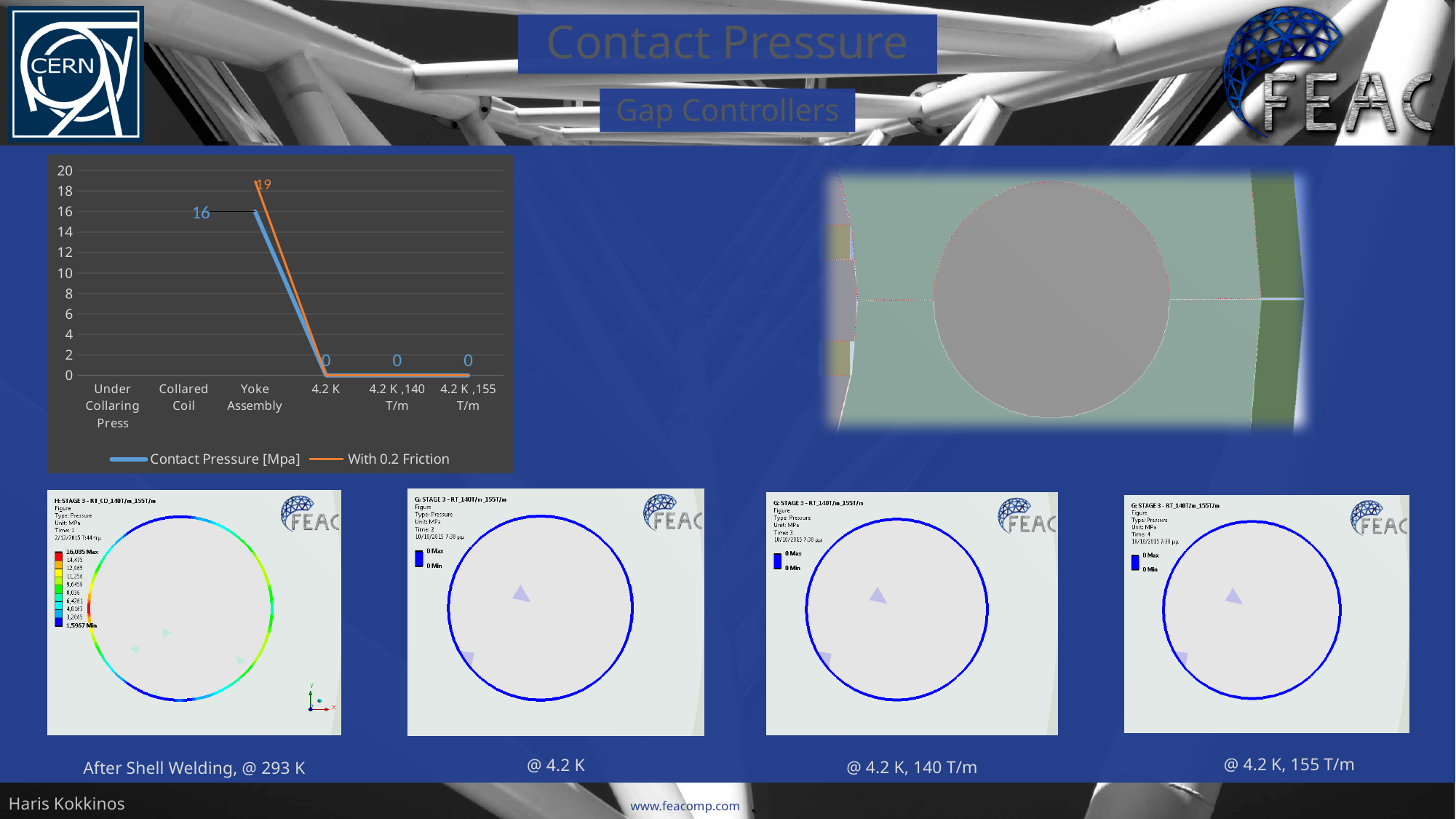
Which category has the highest Contact Pressure [Mpa] value? Yoke Assembly Do the values rise or fall from Yoke Assembly to 4.2 K? fall What are the two legend entries of the chart? Contact Pressure [Mpa] and With 0.2 Friction At Yoke Assembly, which series has the larger value, Contact Pressure [Mpa] or With 0.2 Friction? With 0.2 Friction What is the difference between the With 0.2 Friction value and the Contact Pressure [Mpa] value at Yoke Assembly? 3 What is the With 0.2 Friction value at Yoke Assembly? 19 What is the Contact Pressure [Mpa] value at Yoke Assembly? 16 What is the value shown at 4.2 K ,155 T/m? 0 What kind of chart is shown on the slide? line chart What is the value shown at 4.2 K? 0 How many series does the chart legend list? 2 How many categories are shown on the x axis of the chart? 6